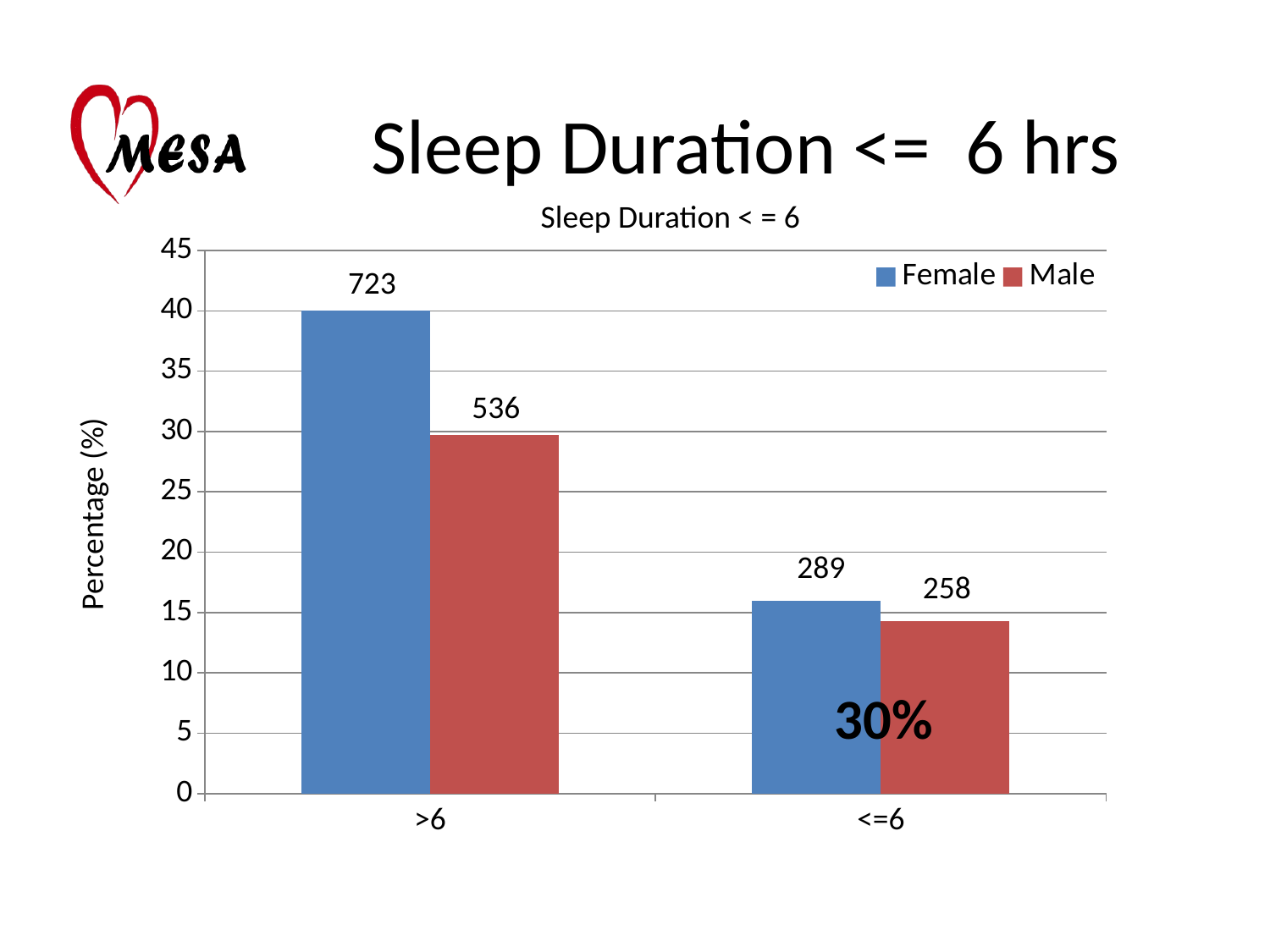
What data label is shown on the Female bar for the <=6 category? 289 Is the Male bar for the >6 category greater or less than 35 on the percentage axis? less What data label is shown on the Male bar for the >6 category? 536 How many categories are shown on the x axis? 2 What is the difference between the data labels on the Female and Male bars for the >6 category? 187 What is the label of the y axis? Percentage (%) Which bar is the shortest in the chart? Male, <=6 What data label is shown on the Female bar for the >6 category? 723 What data label is shown on the Male bar for the <=6 category? 258 Which bar is the tallest in the chart? Female, >6 What type of chart is shown on the slide? bar chart How many series does the legend list? 2